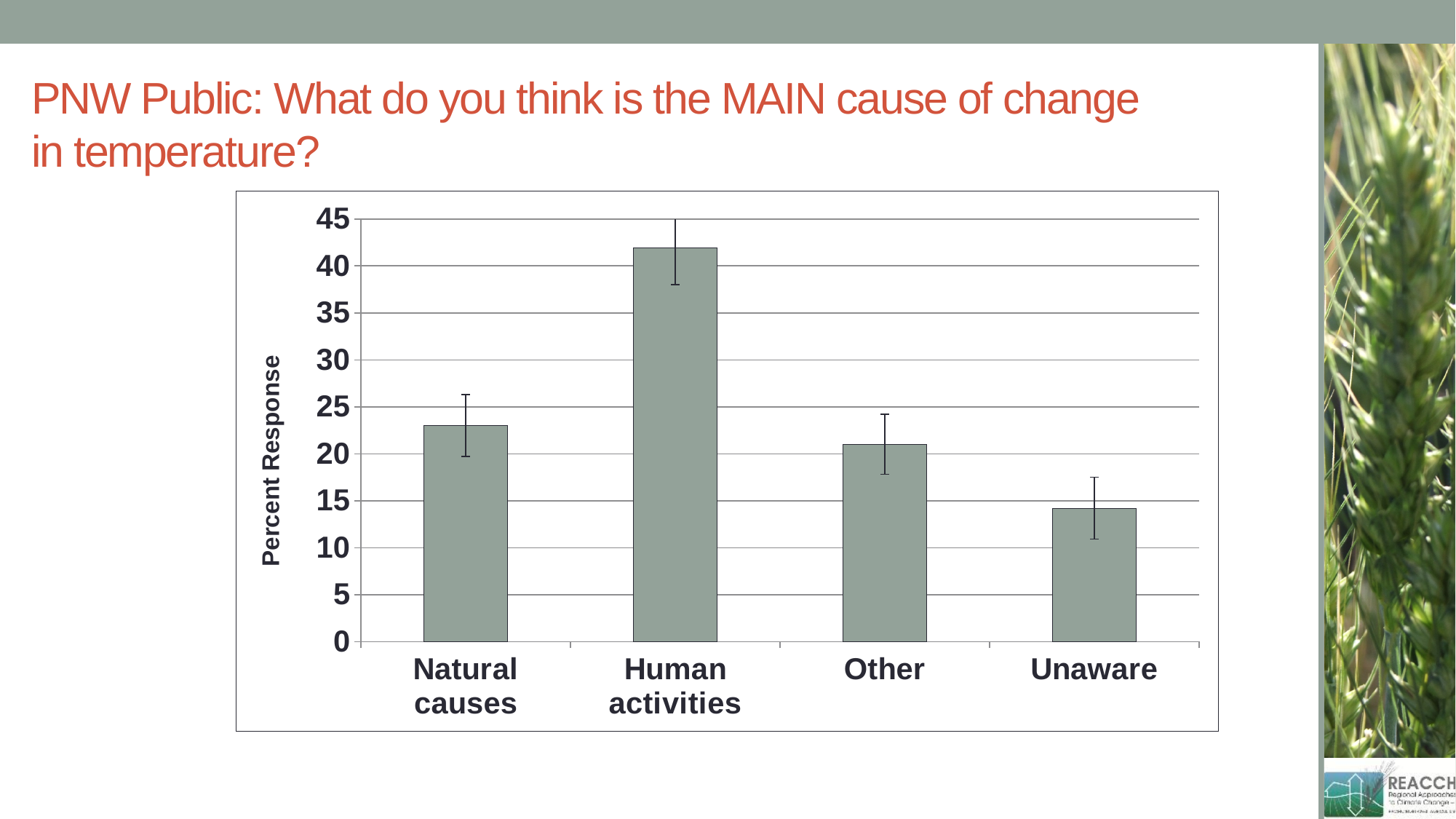
How many categories are shown on the x axis of the chart? 4 Is the value for Other greater or less than 25? less Is the value for Natural causes greater or less than 20? greater Is the value for Human activities greater or less than 40? greater Which category has the highest percent response? Human activities What is the label of the y axis of the chart? Percent Response Which is larger, the value for Natural causes or the value for Unaware? Natural causes Which is larger, the value for Human activities or the value for Other? Human activities Which category has the lowest percent response? Unaware What type of chart is shown on the slide? bar chart What is the maximum value shown on the y axis of the chart? 45